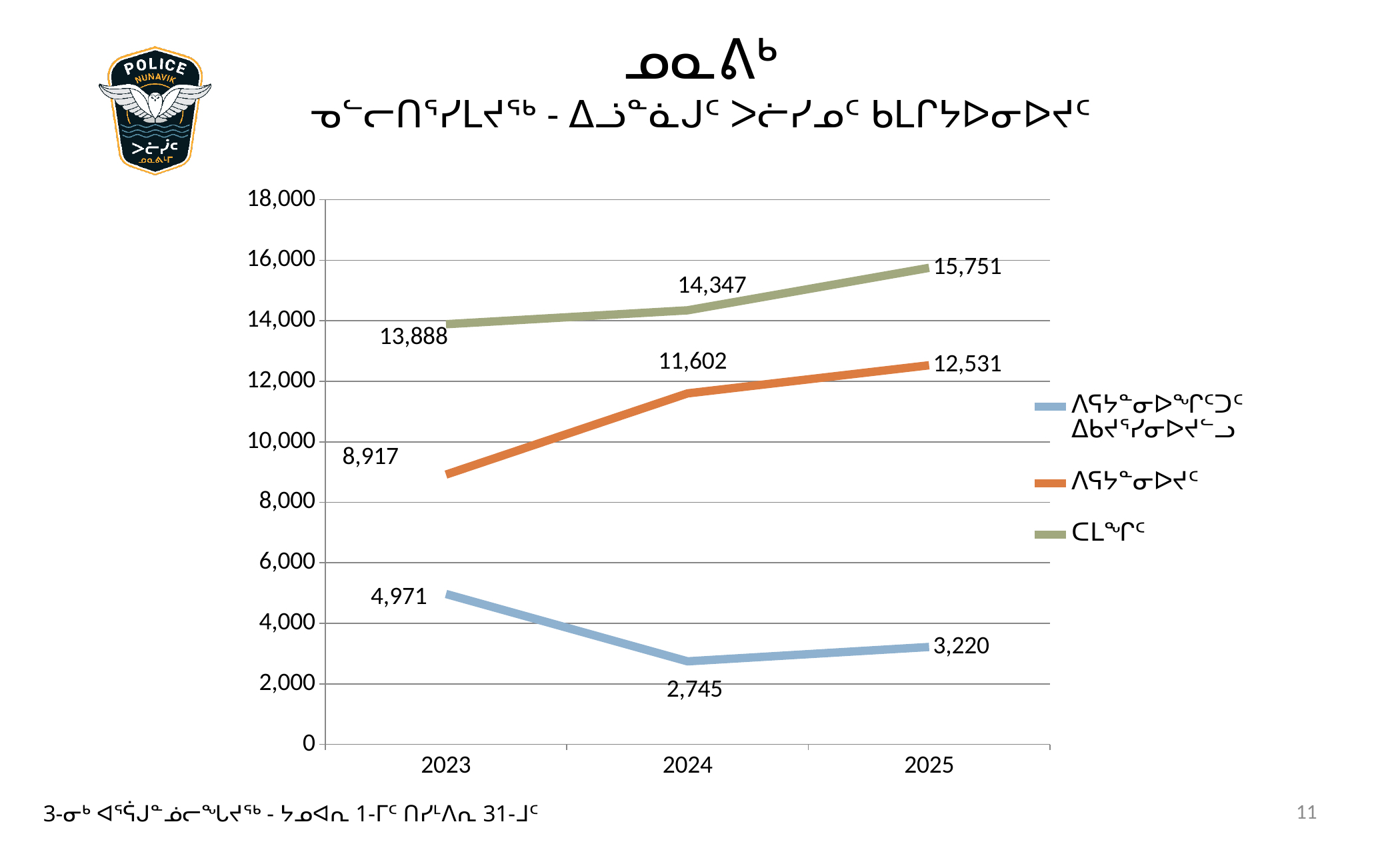
In which year does the blue line have its lowest value? 2024 Does the orange line rise or fall from 2023 to 2025? Rise How many series does the legend list? 3 What is the value of the green line in 2025? 15,751 By how much did the green line increase from 2023 to 2025? 1,863 What kind of chart is shown on the slide? Line chart In which year does the green line reach its highest value? 2025 What is the value of the blue line in 2023? 4,971 What is the difference between the orange line's 2024 and 2023 values? 2,685 How many years are shown on the x axis? 3 Which is larger: the orange line's value in 2025 or the green line's value in 2023? The green line's value in 2023 What is the value of the orange line in 2024? 11,602